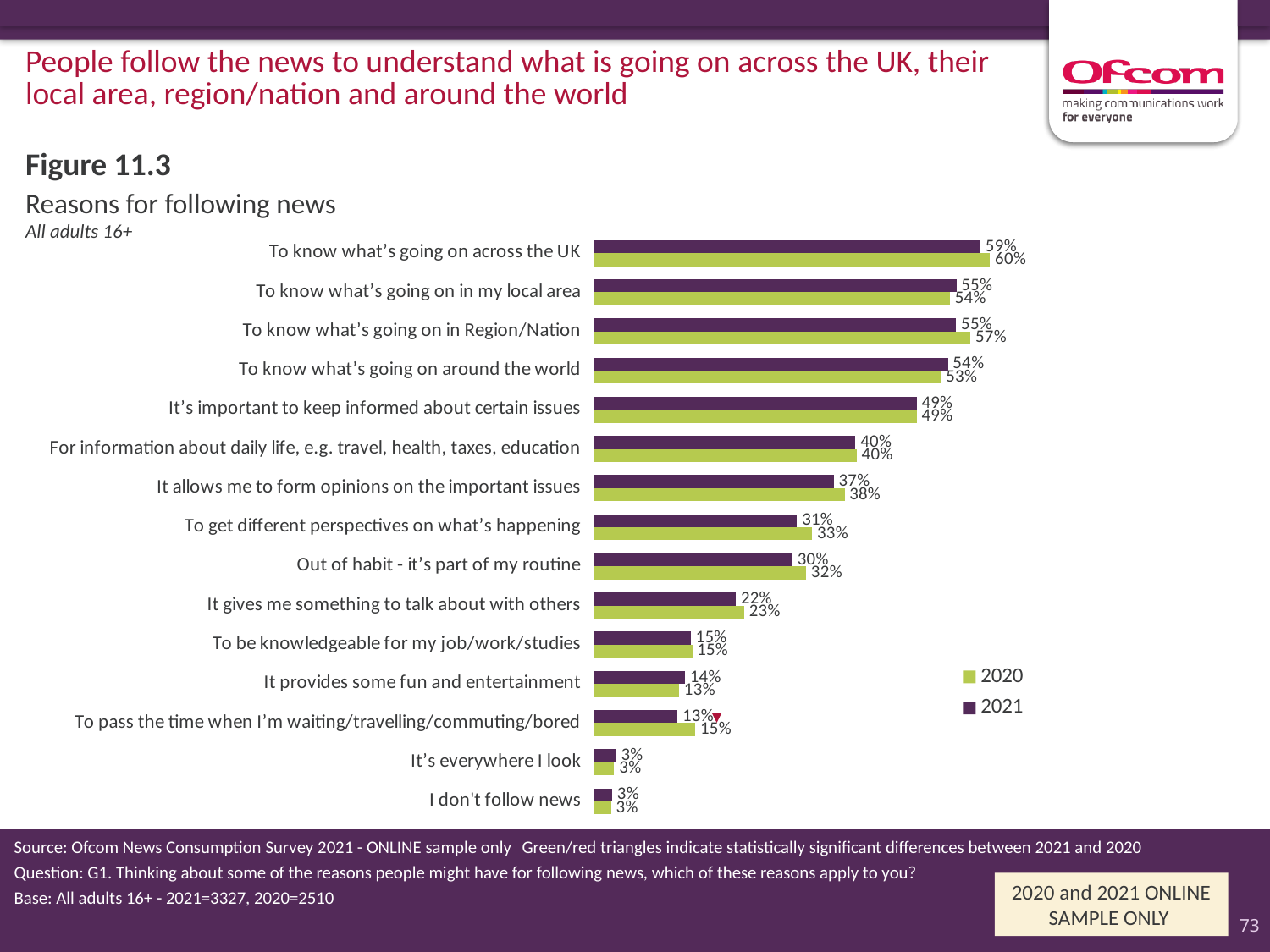
What is the difference between the 2020 and 2021 values for "To get different perspectives on what's happening"? 2% What is the 2021 value for "For information about daily life, e.g. travel, health, taxes, education"? 40% What kind of chart is shown on the slide? Bar chart Which reason has the highest 2021 value? To know what's going on across the UK Which colour represents the 2020 series in the chart? Green What is the 2020 value for "To know what's going on in Region/Nation"? 57% What is the 2021 value for "To know what's going on across the UK"? 59% What is the 2020 value for "To pass the time when I'm waiting/travelling/commuting/bored"? 15% What is the 2021 value for "Out of habit - it's part of my routine"? 30% Which is larger for "It provides some fun and entertainment": the 2020 value or the 2021 value? 2021 How many series does the legend list? 2 How many reasons (categories) are shown in the chart? 15